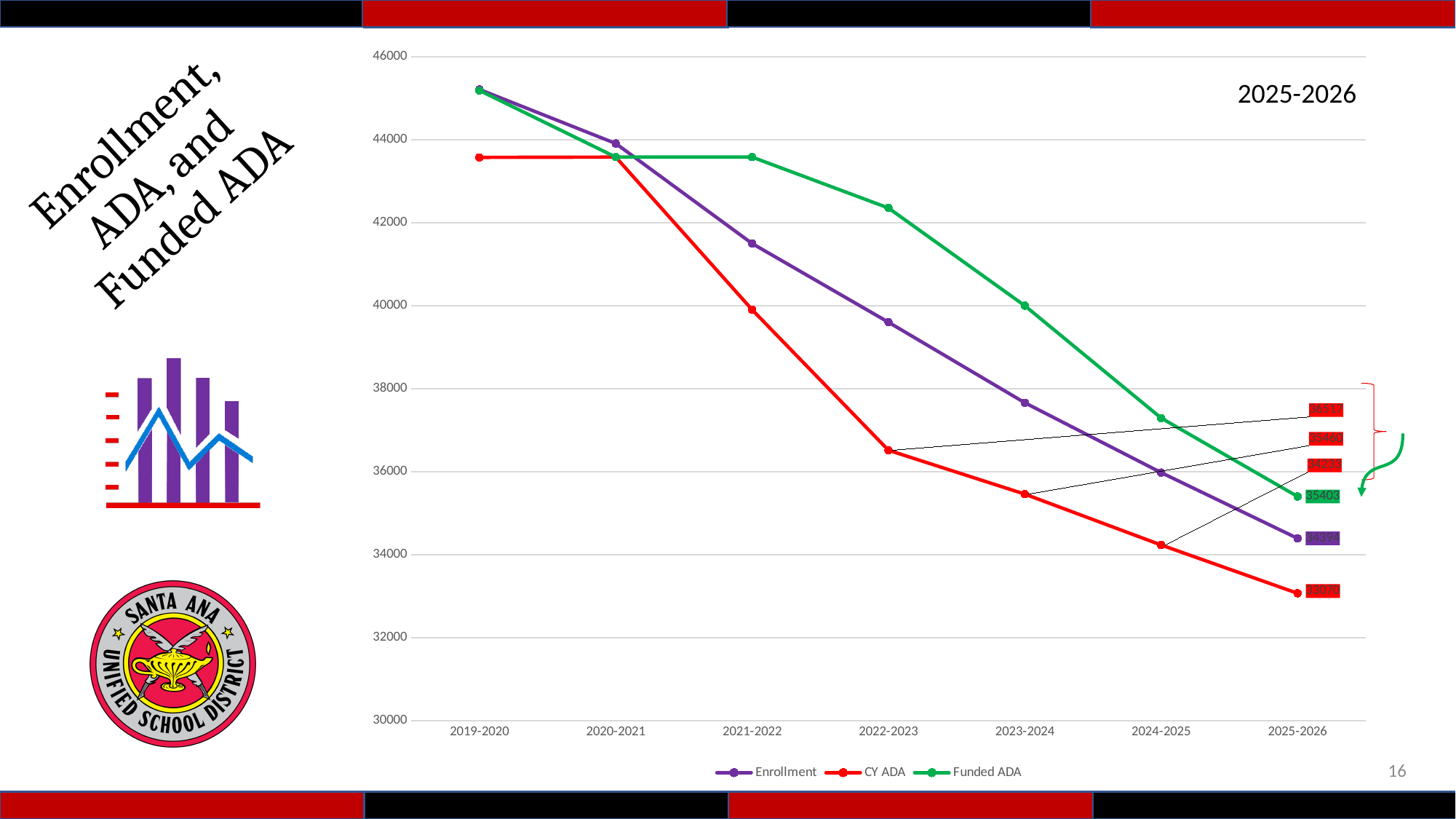
What is the Enrollment value for 2025-2026? 34394 In 2025-2026, which is larger: Funded ADA or Enrollment? Funded ADA Is the CY ADA value for 2022-2023 greater or less than 38000? less Does the Enrollment line rise or fall from 2019-2020 to 2025-2026? fall Which series has the highest value in 2025-2026? Funded ADA Is the Enrollment value for 2019-2020 greater or less than 44000? greater How many series does the chart's legend list? 3 What is the Funded ADA value for 2025-2026? 35403 How many school years are shown along the x axis of the chart? 7 What is the difference between Funded ADA and Enrollment in 2025-2026? 1009 What is the CY ADA value for 2025-2026? 33070 What kind of chart is shown on the slide? line chart